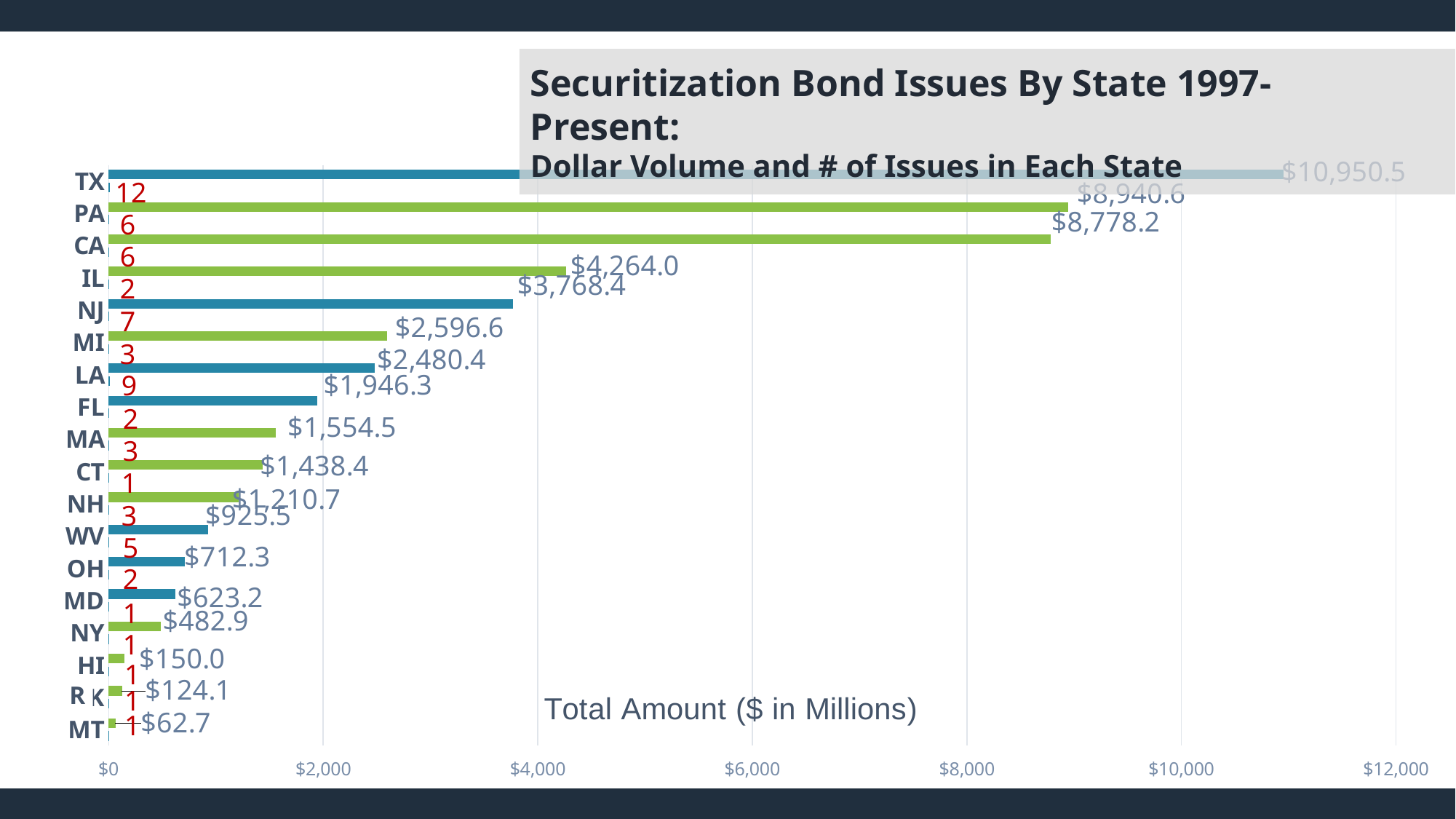
Which state has the highest total amount? TX Which has a larger total amount, IL or NJ? IL How many states are shown on the chart? 18 Which state has the lowest total amount? MT What kind of chart is shown on the slide? Bar chart Is the value for MI greater or less than $2,000? greater What is the total amount for TX? $10,950.5 What is the difference between the total amounts for FL and MA? $391.8 What is the difference between the total amounts for PA and CA? $162.4 What is the x-axis label of the chart? Total Amount ($ in Millions) What is the total amount for LA? $2,480.4 How many issues are shown in red for TX? 12